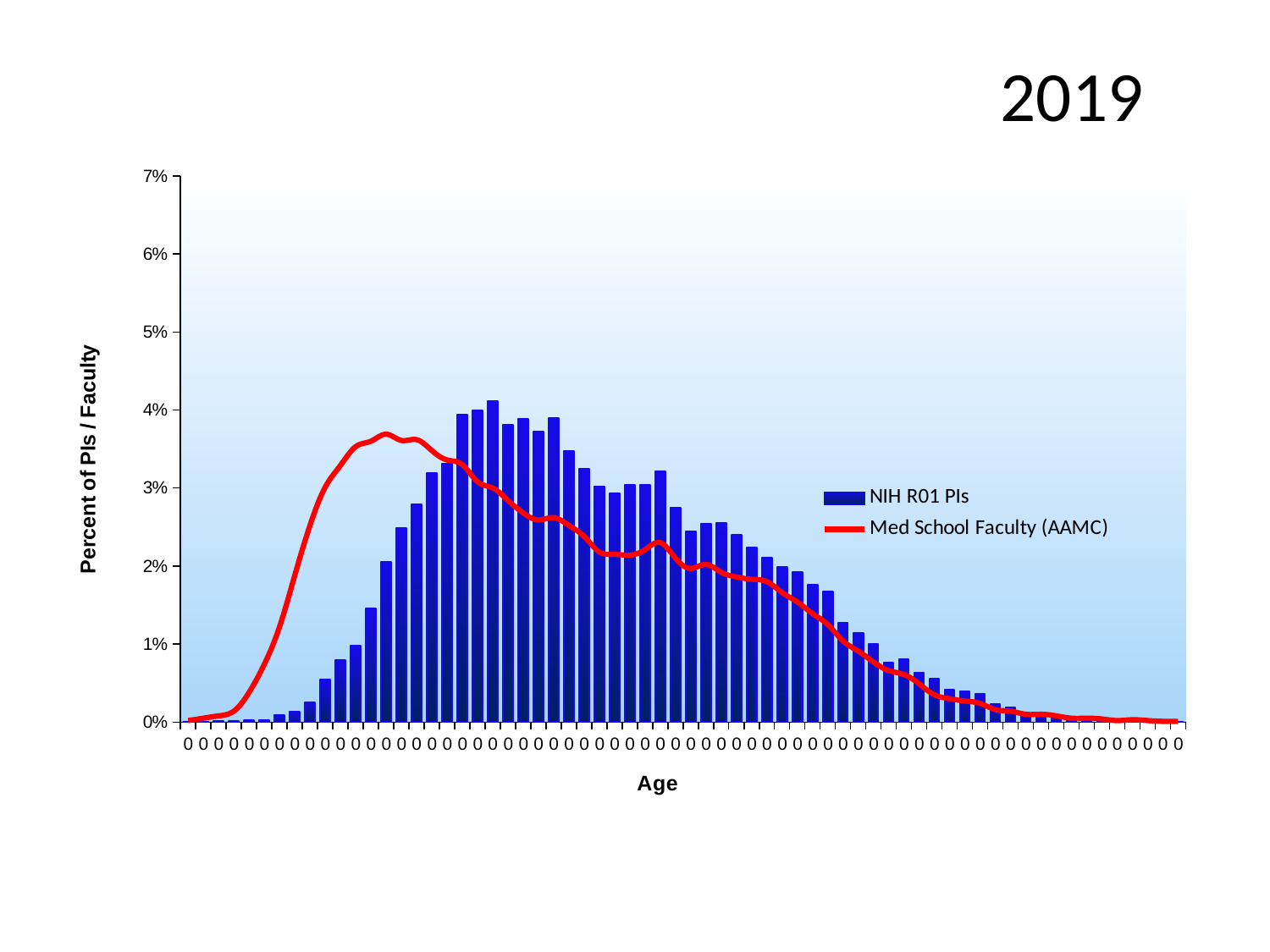
What is the title of the y axis? Percent of PIs / Faculty Do the NIH R01 PIs bars rise or fall along the right-hand half of the x axis? fall Is the peak value of the NIH R01 PIs bars greater or less than 3%? greater What kind of chart is shown on the slide? A bar chart with a line overlay Which series reaches a higher peak value, NIH R01 PIs or Med School Faculty (AAMC)? NIH R01 PIs Which series is drawn as a red line? Med School Faculty (AAMC) Is the peak value of the Med School Faculty (AAMC) line greater or less than 4%? less What is the highest tick value shown on the y axis? 7% What are the two series named in the legend? NIH R01 PIs and Med School Faculty (AAMC) What is the title of the x axis? Age How many series does the legend list? 2 What year is shown as the slide title? 2019